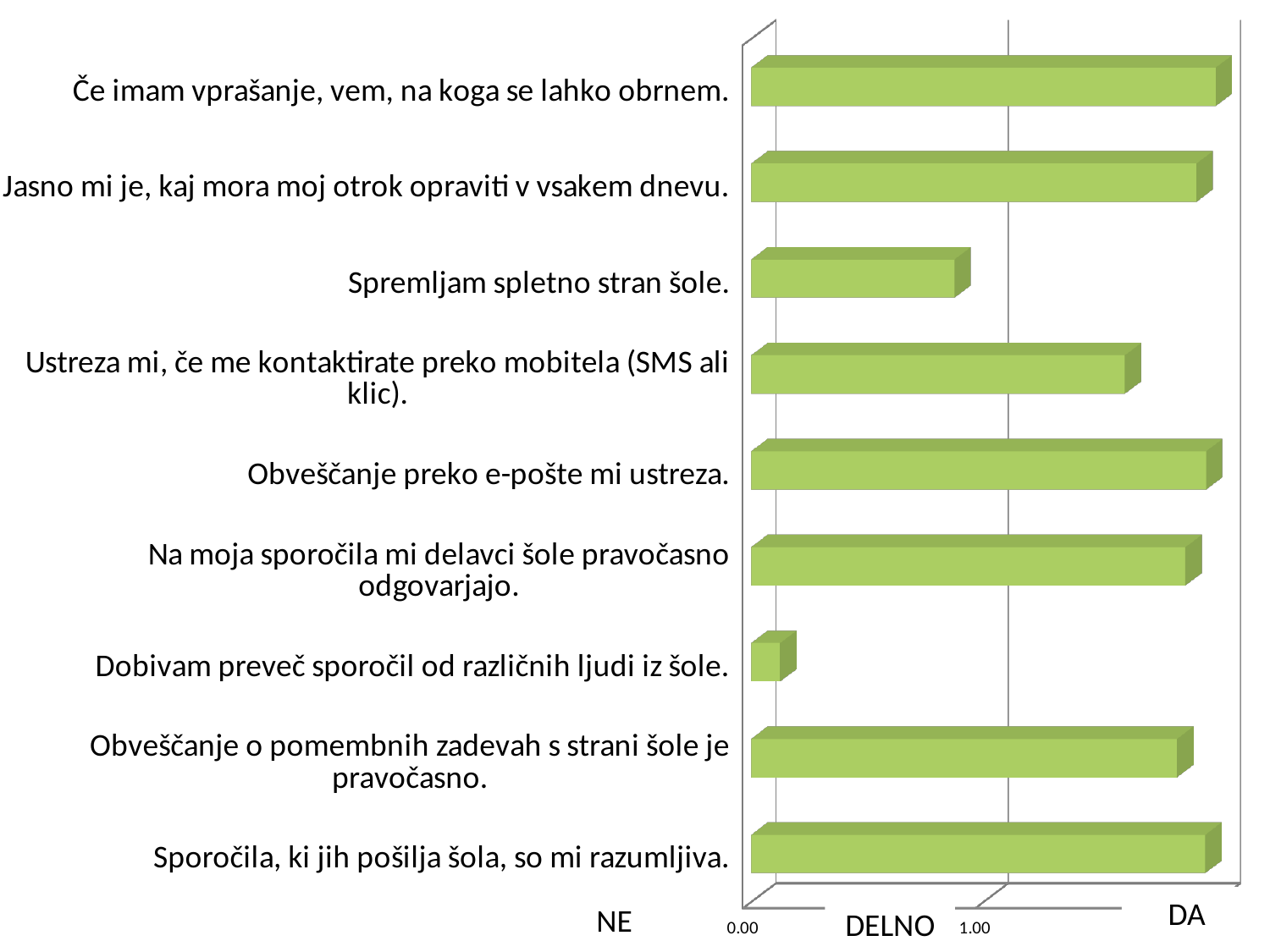
Is the value for "Spremljam spletno stran šole." greater or less than 1.00? less What colour are the bars in the chart? green How many categories (statements) are plotted in the chart? 9 Which statement has the lowest value in the chart? Dobivam preveč sporočil od različnih ljudi iz šole. Is the value for "Jasno mi je, kaj mora moj otrok opraviti v vsakem dnevu." greater or less than 1.00? greater Which has the larger value: "Spremljam spletno stran šole." or "Ustreza mi, če me kontaktirate preko mobitela (SMS ali klic)."? Ustreza mi, če me kontaktirate preko mobitela (SMS ali klic). What kind of chart is shown on the slide? bar chart Is the value for "Ustreza mi, če me kontaktirate preko mobitela (SMS ali klic)." greater or less than 1.00? greater Which has the larger value: "Obveščanje preko e-pošte mi ustreza." or "Spremljam spletno stran šole."? Obveščanje preko e-pošte mi ustreza. What three response labels are shown along the bottom of the chart's horizontal axis? NE, DELNO, DA Which has the larger value: "Dobivam preveč sporočil od različnih ljudi iz šole." or "Spremljam spletno stran šole."? Spremljam spletno stran šole.